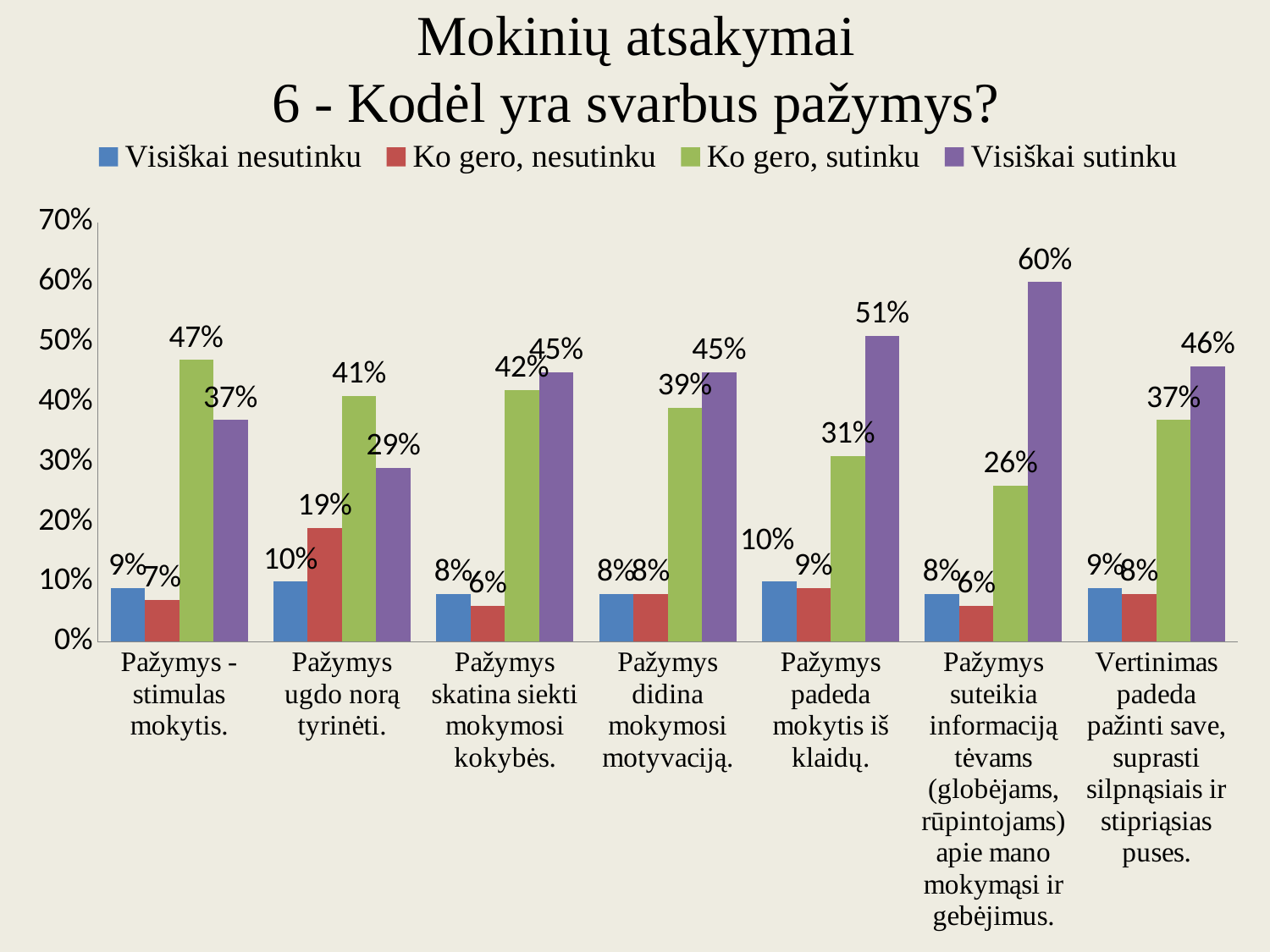
What is the difference between the "Visiškai sutinku" and "Ko gero, sutinku" values for "Pažymys padeda mokytis iš klaidų."? 20% How many series does the legend list? 4 Which category has the highest "Visiškai sutinku" value? Pažymys suteikia informaciją tėvams (globėjams, rūpintojams) apie mano mokymąsi ir gebėjimus. Which category has the lowest "Ko gero, sutinku" value? Pažymys suteikia informaciją tėvams (globėjams, rūpintojams) apie mano mokymąsi ir gebėjimus. How many categories are shown on the x axis? 7 What type of chart is shown on the slide? bar chart What is the value of "Visiškai sutinku" for "Pažymys suteikia informaciją tėvams (globėjams, rūpintojams) apie mano mokymąsi ir gebėjimus."? 60% What is the value of "Ko gero, nesutinku" for "Pažymys ugdo norą tyrinėti."? 19% For "Pažymys ugdo norą tyrinėti.", which is larger: "Ko gero, sutinku" or "Visiškai sutinku"? Ko gero, sutinku What is the value of "Visiškai nesutinku" for "Pažymys padeda mokytis iš klaidų."? 10% What is the title of the chart? Mokinių atsakymai 6 - Kodėl yra svarbus pažymys? What is the value of "Ko gero, sutinku" for "Pažymys - stimulas mokytis."? 47%